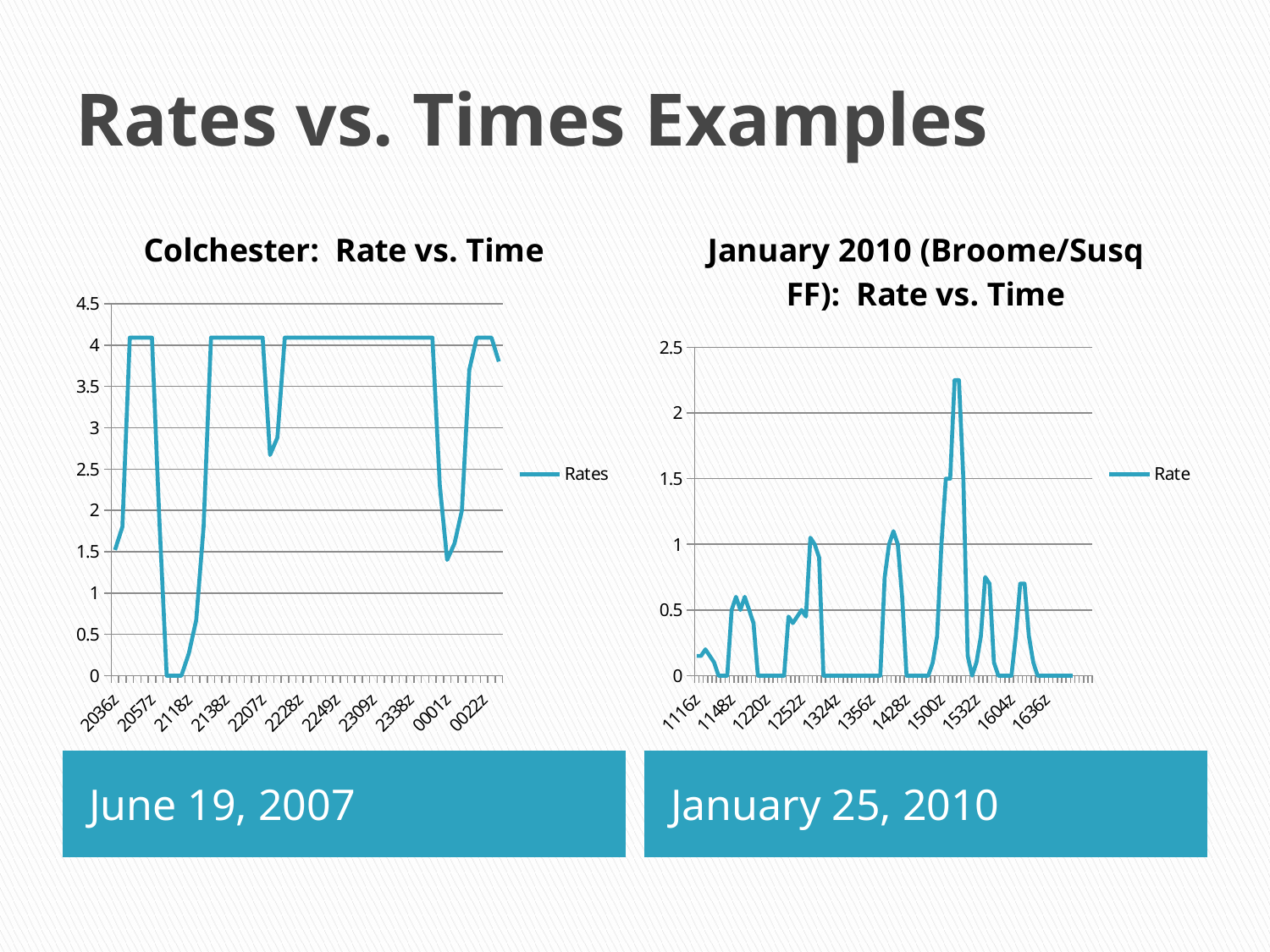
How many time labels are shown on the x axis of the January 2010 (Broome/Susq FF): Rate vs. Time chart? 11 What is the highest value shown on the y axis of the January 2010 (Broome/Susq FF): Rate vs. Time chart? 2.5 On the January 2010 (Broome/Susq FF): Rate vs. Time chart, is the highest peak of the line greater or less than 2? greater What is the legend entry on the Colchester: Rate vs. Time chart? Rates What kind of chart is the January 2010 (Broome/Susq FF): Rate vs. Time chart? line chart Which chart reaches a higher maximum value, the Colchester: Rate vs. Time chart or the January 2010 (Broome/Susq FF): Rate vs. Time chart? Colchester: Rate vs. Time On the Colchester: Rate vs. Time chart, is the highest value reached by the line greater or less than 3.5? greater What kind of chart is the Colchester: Rate vs. Time chart? line chart How many series does the legend of the Colchester: Rate vs. Time chart list? 1 On the January 2010 (Broome/Susq FF): Rate vs. Time chart, is the value at 1116z greater or less than 0.5? less What is the legend entry on the January 2010 (Broome/Susq FF): Rate vs. Time chart? Rate